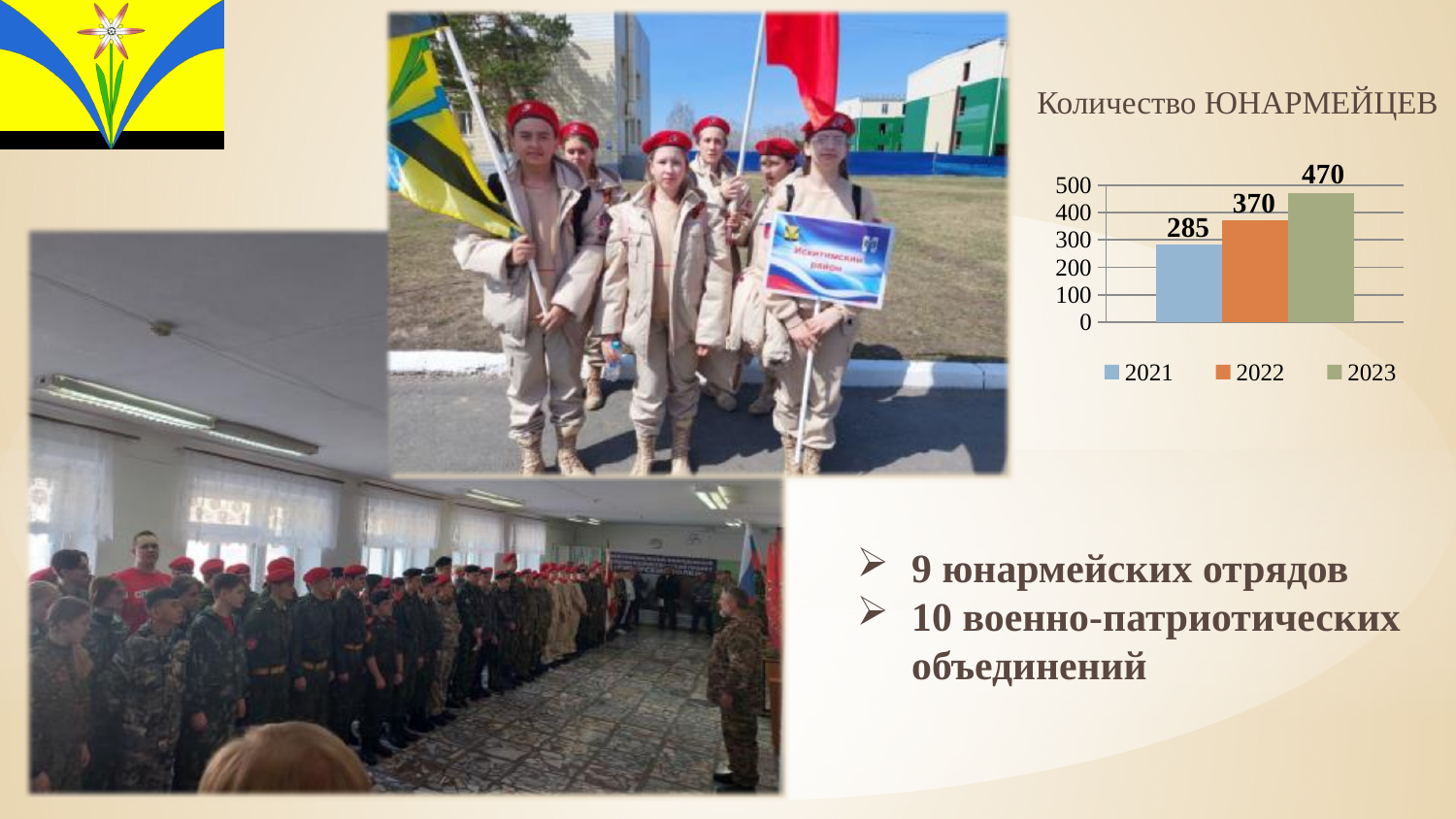
Which year has the lowest value in the chart? 2021 What is the title of the chart? Количество ЮНАРМЕЙЦЕВ What is the difference between the values for 2023 and 2021? 185 What kind of chart is shown on the slide? bar chart Is the value for 2023 greater or less than 400? greater What is the value for 2022 in the chart? 370 How many series does the legend list? 3 Which year has the highest value in the chart? 2023 Which is larger, the value for 2022 or the value for 2023? 2023 What is the value for 2023 in the chart? 470 What is the value for 2021 in the chart? 285 What is the difference between the values for 2022 and 2021? 85